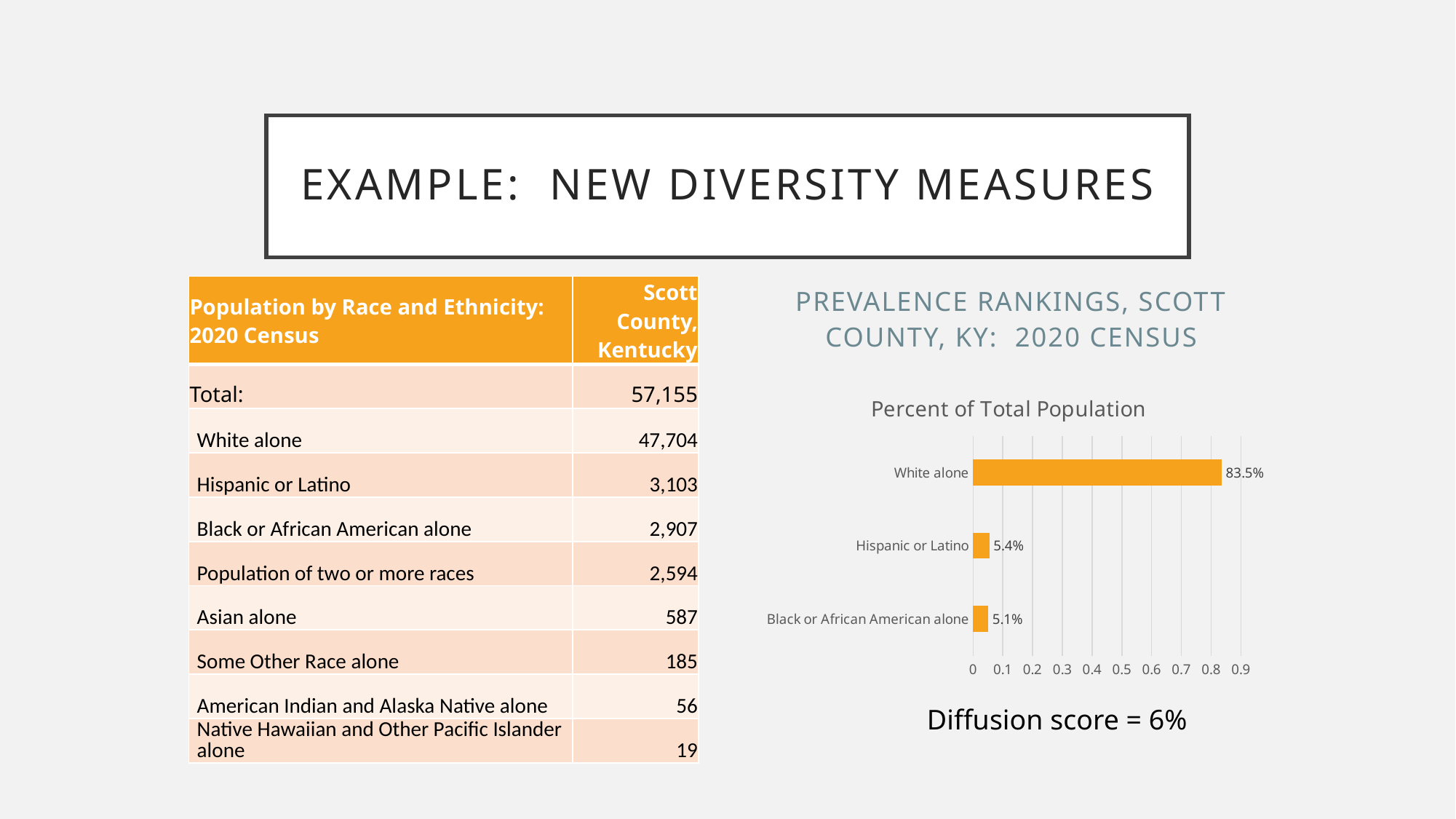
Which category has the lowest value in the Percent of Total Population chart? Black or African American alone What is the value for Hispanic or Latino in the Percent of Total Population chart? 5.4% What is the difference between the White alone and Hispanic or Latino values in the Percent of Total Population chart? 78.1% How many categories are shown in the Percent of Total Population chart? 3 What is the title of the chart on the right side of the slide? Percent of Total Population What kind of chart is the Percent of Total Population chart? Bar chart In the Percent of Total Population chart, is the value for Hispanic or Latino greater or less than 0.1? less What is the value for Black or African American alone in the Percent of Total Population chart? 5.1% What is the difference between the Hispanic or Latino and Black or African American alone values in the Percent of Total Population chart? 0.3% In the Percent of Total Population chart, is the value for White alone greater or less than 0.8? greater Which category has the highest value in the Percent of Total Population chart? White alone What is the value for White alone in the Percent of Total Population chart? 83.5%